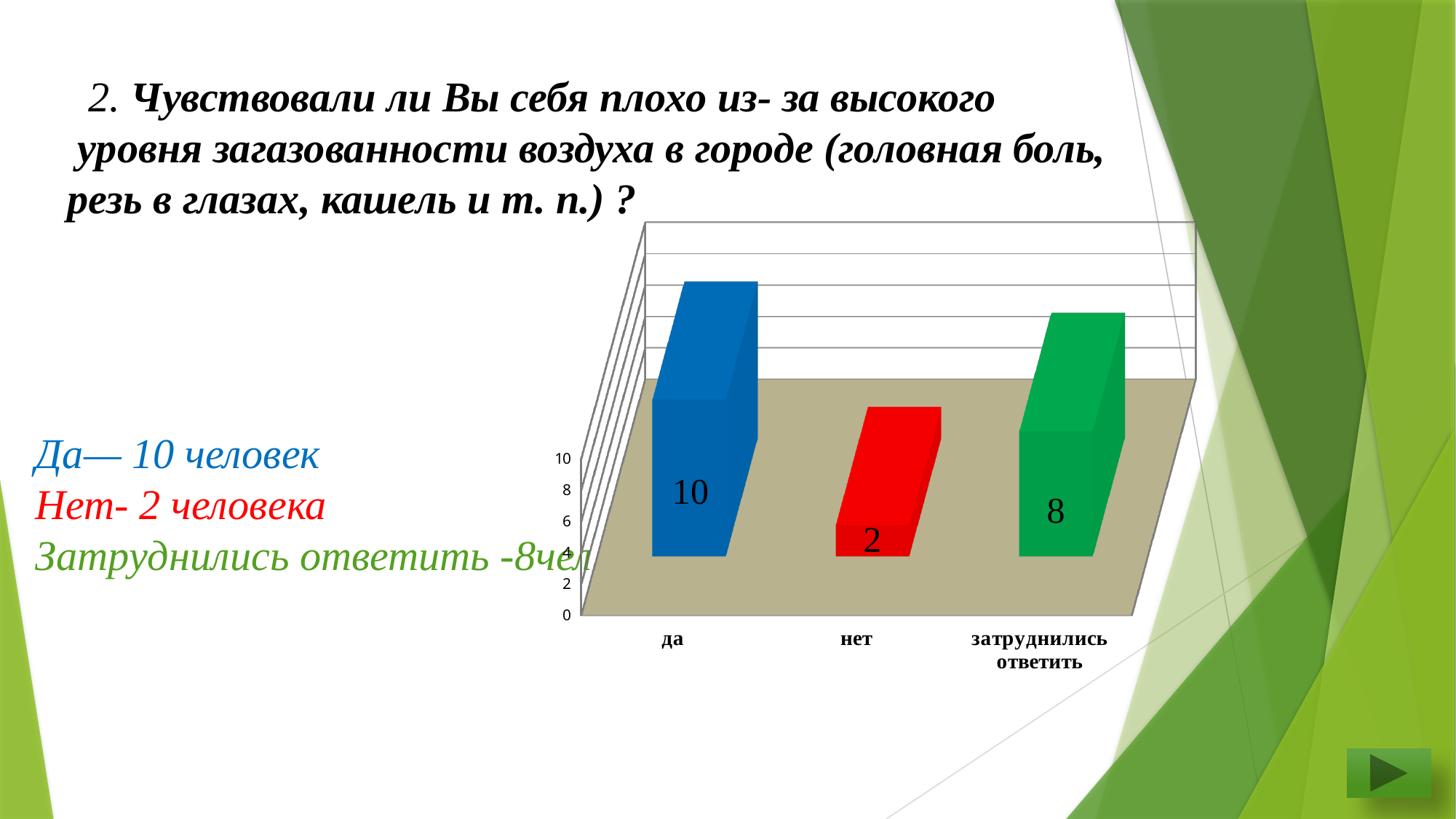
How many categories are shown on the chart? 3 What is the value for "нет"? 2 Which category has the lowest value? нет What is the difference between the values for "да" and "нет"? 8 What is the value for "да"? 10 What is the difference between the values for "да" and "затруднились ответить"? 2 What kind of chart is shown on the slide? bar chart Is the value for "затруднились ответить" greater or less than 6? greater What colour is the bar for "нет"? red Which is larger, the value for "нет" or the value for "затруднились ответить"? затруднились ответить Which category has the highest value? да What is the value for "затруднились ответить"? 8